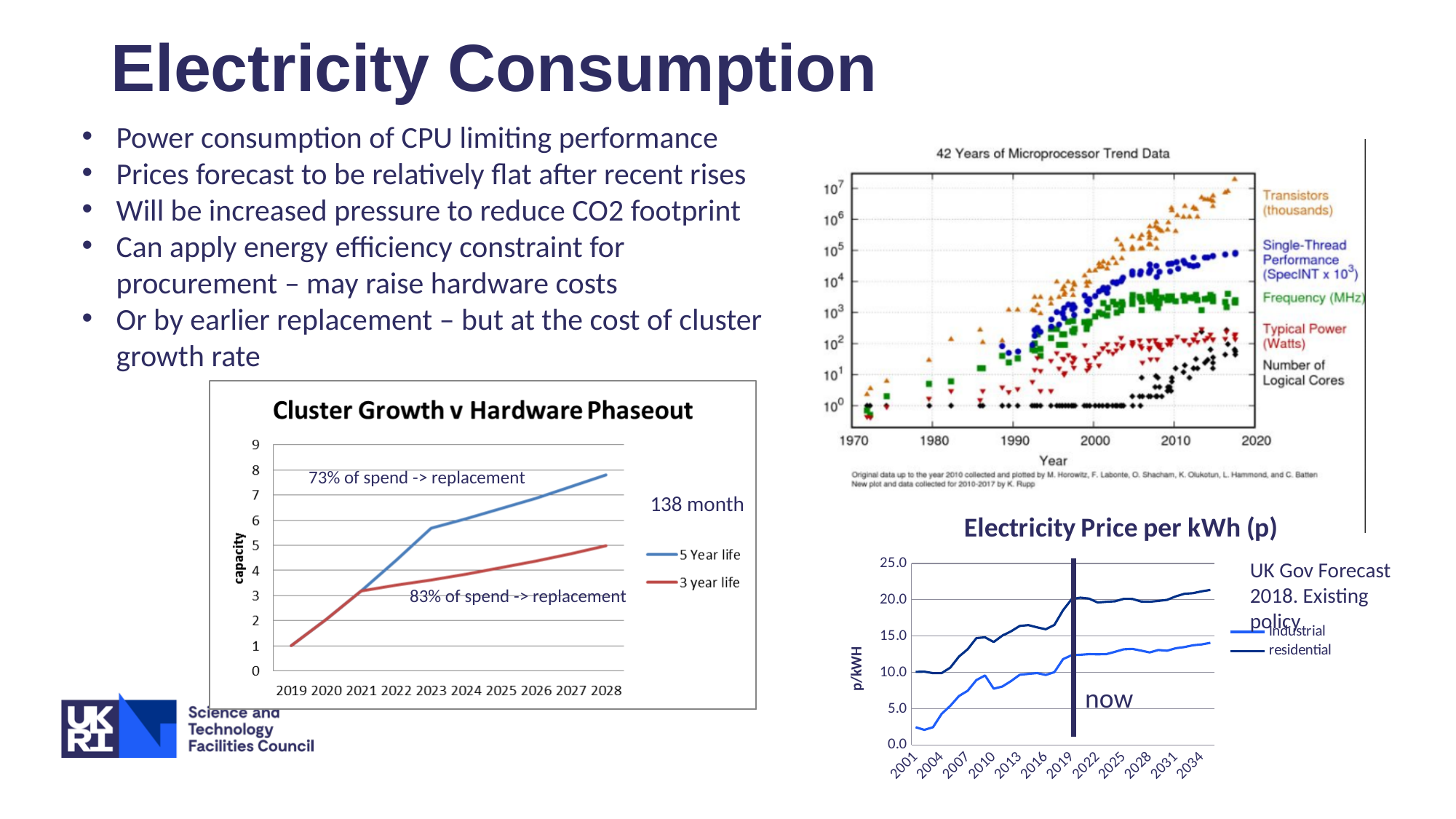
In the "Cluster Growth v Hardware Phaseout" chart, do the 5 Year life values rise or fall from 2019 to 2028? rise In the "Electricity Price per kWh (p)" chart, is the residential value in 2034 greater or less than 20.0? greater How many series does the legend of the "42 Years of Microprocessor Trend Data" chart list? 5 What kind of chart is the "Cluster Growth v Hardware Phaseout" chart? line chart In the "Electricity Price per kWh (p)" chart, which series is higher in 2019, industrial or residential? residential In the "Electricity Price per kWh (p)" chart, is the industrial value in 2001 greater or less than 5.0? less In the "Cluster Growth v Hardware Phaseout" chart, which series is higher in 2028, 5 Year life or 3 year life? 5 Year life In the "Cluster Growth v Hardware Phaseout" chart, is the 5 Year life value in 2028 greater or less than 7? greater In the "Cluster Growth v Hardware Phaseout" chart, how many years are shown on the x axis? 10 How many series does the legend of the "Cluster Growth v Hardware Phaseout" chart list? 2 How many series does the legend of the "Electricity Price per kWh (p)" chart list? 2